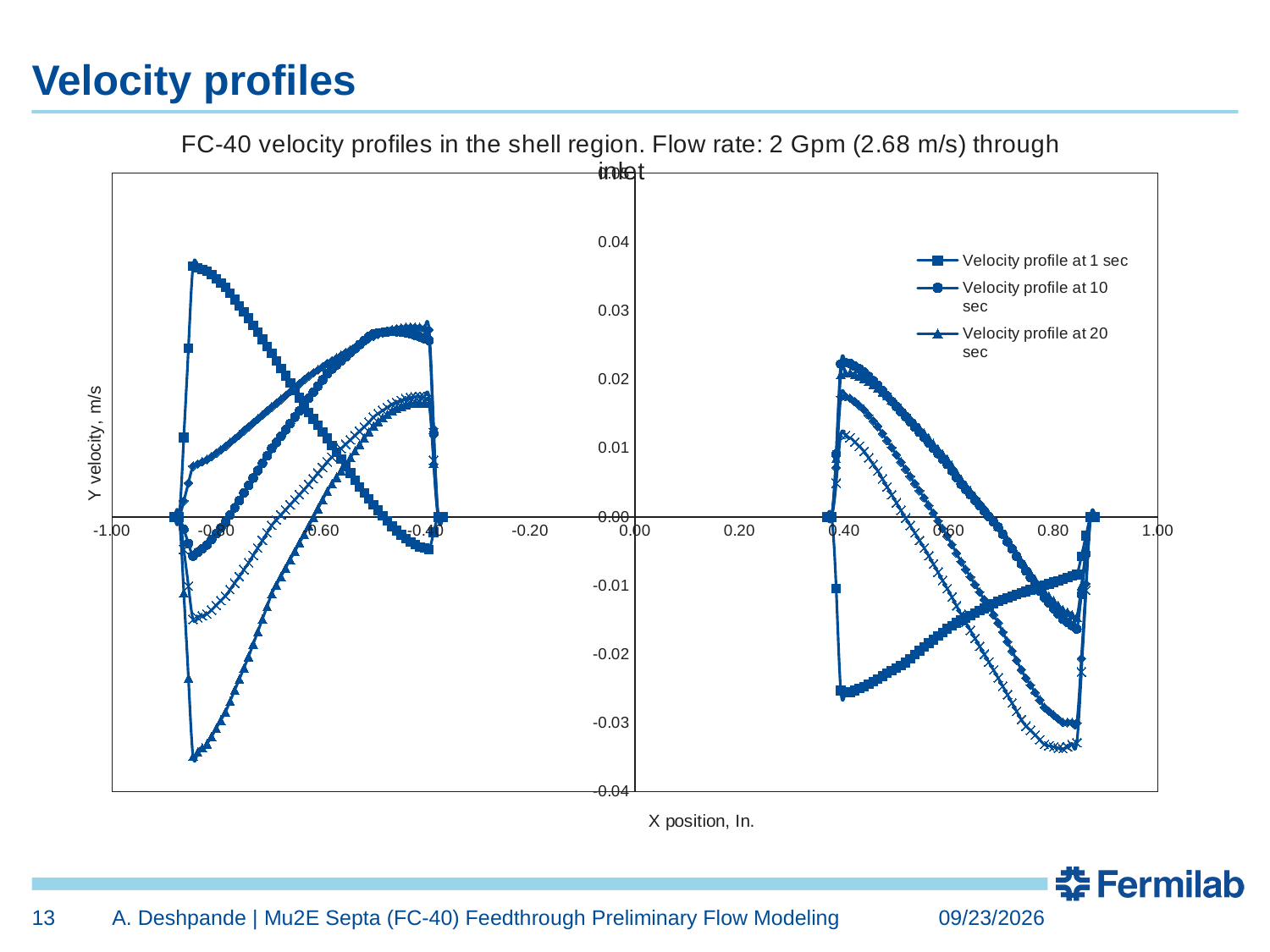
Which series reaches a lower minimum Y velocity, 'Velocity profile at 1 sec' or 'Velocity profile at 20 sec'? Velocity profile at 20 sec Is the lowest Y velocity of the 'Velocity profile at 20 sec' series greater or less than -0.03? less Between x = 0.40 and x = 0.80, does the 'Velocity profile at 10 sec' series rise or fall? fall Is the peak Y velocity of the 'Velocity profile at 1 sec' series greater or less than 0.03? greater Which series reaches the highest Y velocity on the chart? Velocity profile at 1 sec Is the lowest Y velocity of the 'Velocity profile at 1 sec' series greater or less than -0.03? greater What is the label of the x axis? X position, In. How many series does the legend list? 3 Which series reaches a higher peak Y velocity, 'Velocity profile at 1 sec' or 'Velocity profile at 10 sec'? Velocity profile at 1 sec What kind of chart is shown on the slide? line chart What is the label of the y axis? Y velocity, m/s